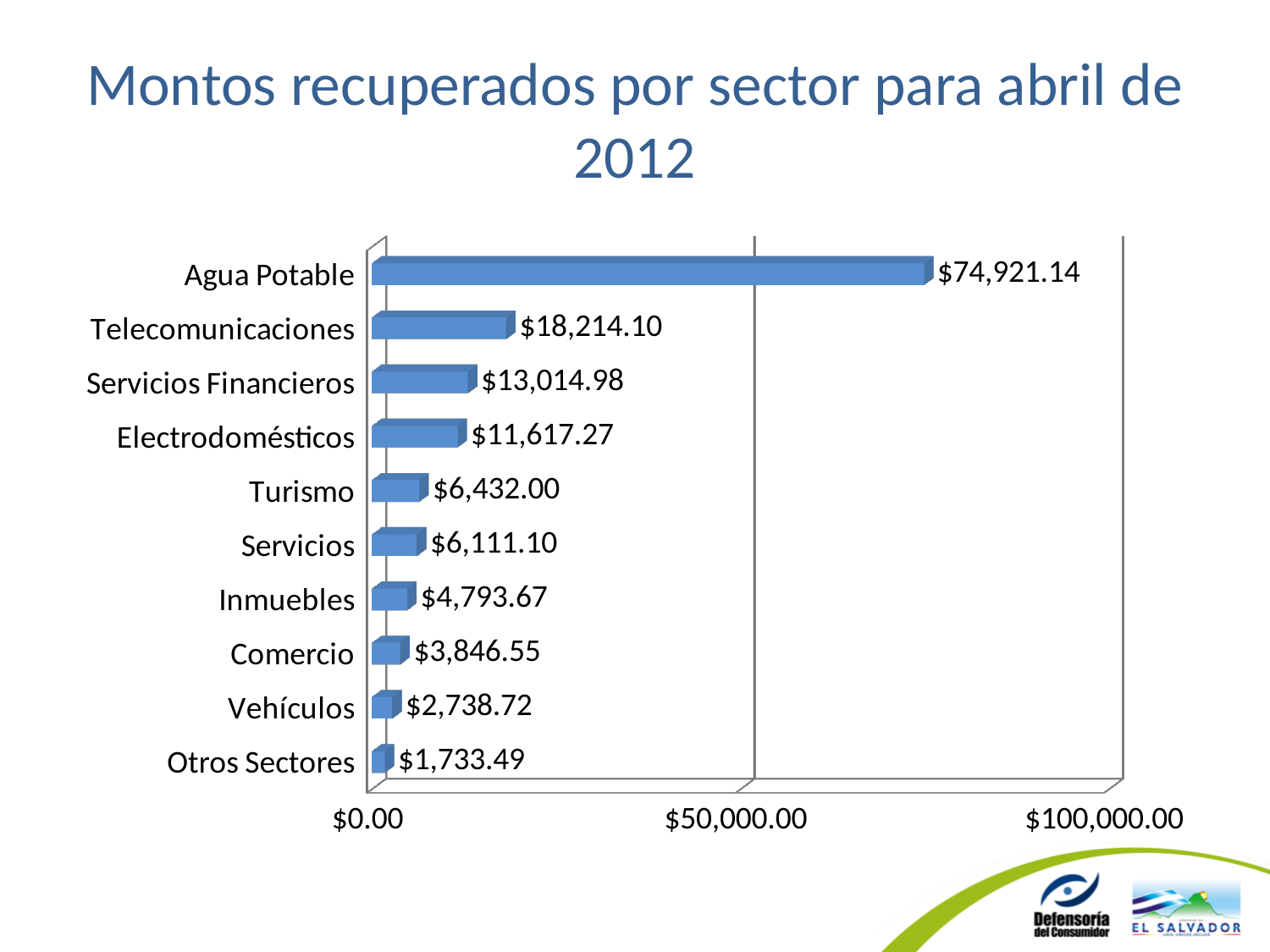
What is the difference between the values for Telecomunicaciones and Servicios Financieros? $5,199.12 Is the value for Agua Potable greater or less than $50,000.00? greater What is the value for Agua Potable? $74,921.14 What is the value for Otros Sectores? $1,733.49 How many sectors are shown in the chart? 10 What kind of chart is shown on the slide? Bar chart What is the value for Turismo? $6,432.00 What is the value for Telecomunicaciones? $18,214.10 Which sector has the lowest recovered amount? Otros Sectores What is the title of the slide? Montos recuperados por sector para abril de 2012 Which sector has the highest recovered amount? Agua Potable Which is larger, the value for Inmuebles or the value for Comercio? Inmuebles